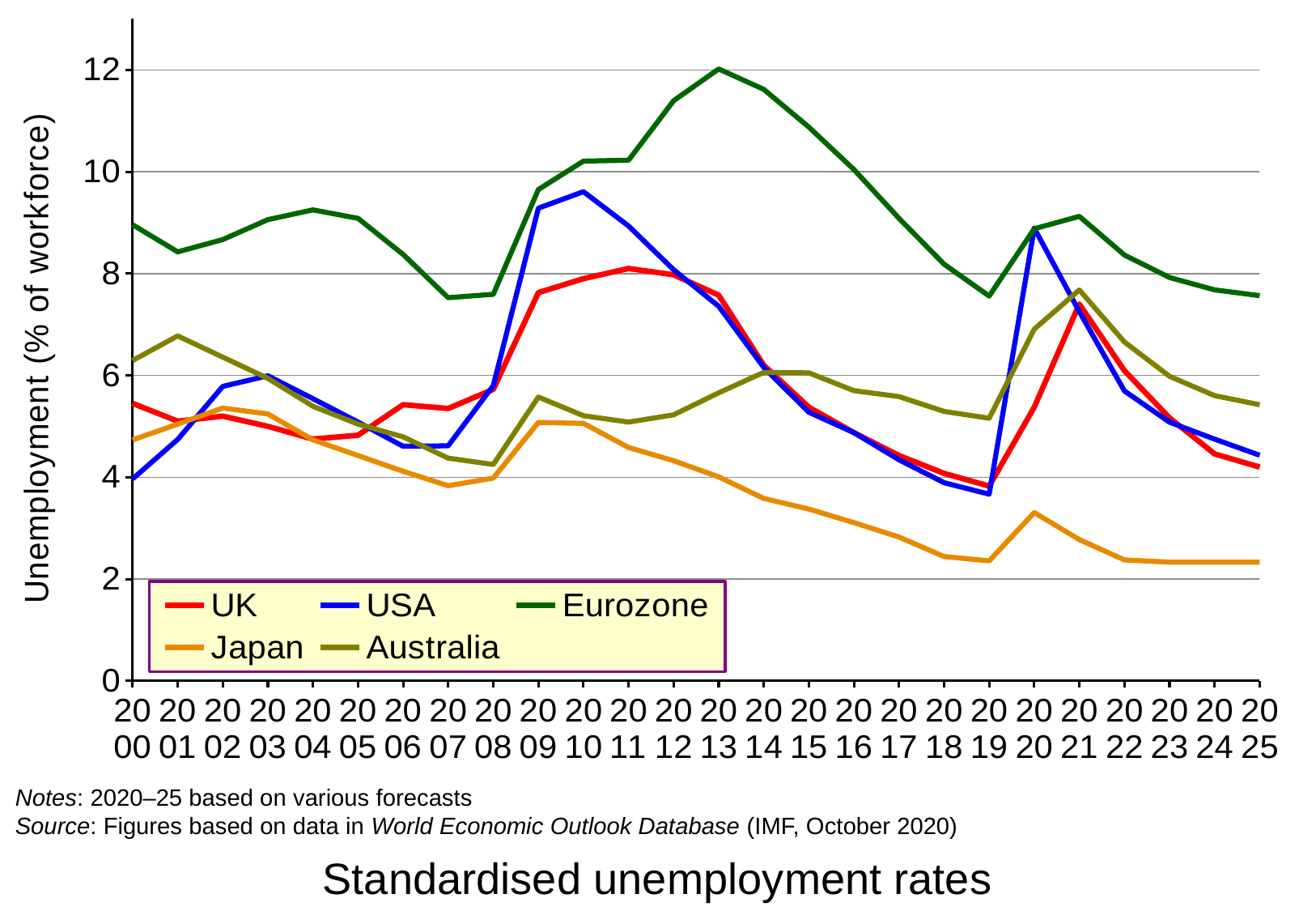
How many series does the legend list? 5 In which year does the Eurozone line reach its highest value? 2013 Is the Eurozone value for 2013 greater or less than 10? greater How many years are shown along the x axis? 26 Which series has the highest unemployment rate in 2013? Eurozone Is the Japan value for 2022 greater or less than 4? less What is the title of the chart? Standardised unemployment rates Which series has the lowest unemployment rate in 2019? Japan In 2000, which is larger, the UK value or the USA value? UK Does the Japan line rise or fall from 2013 to 2019? fall What kind of chart is shown on the slide? line chart Is the USA value for 2010 greater or less than 8? greater